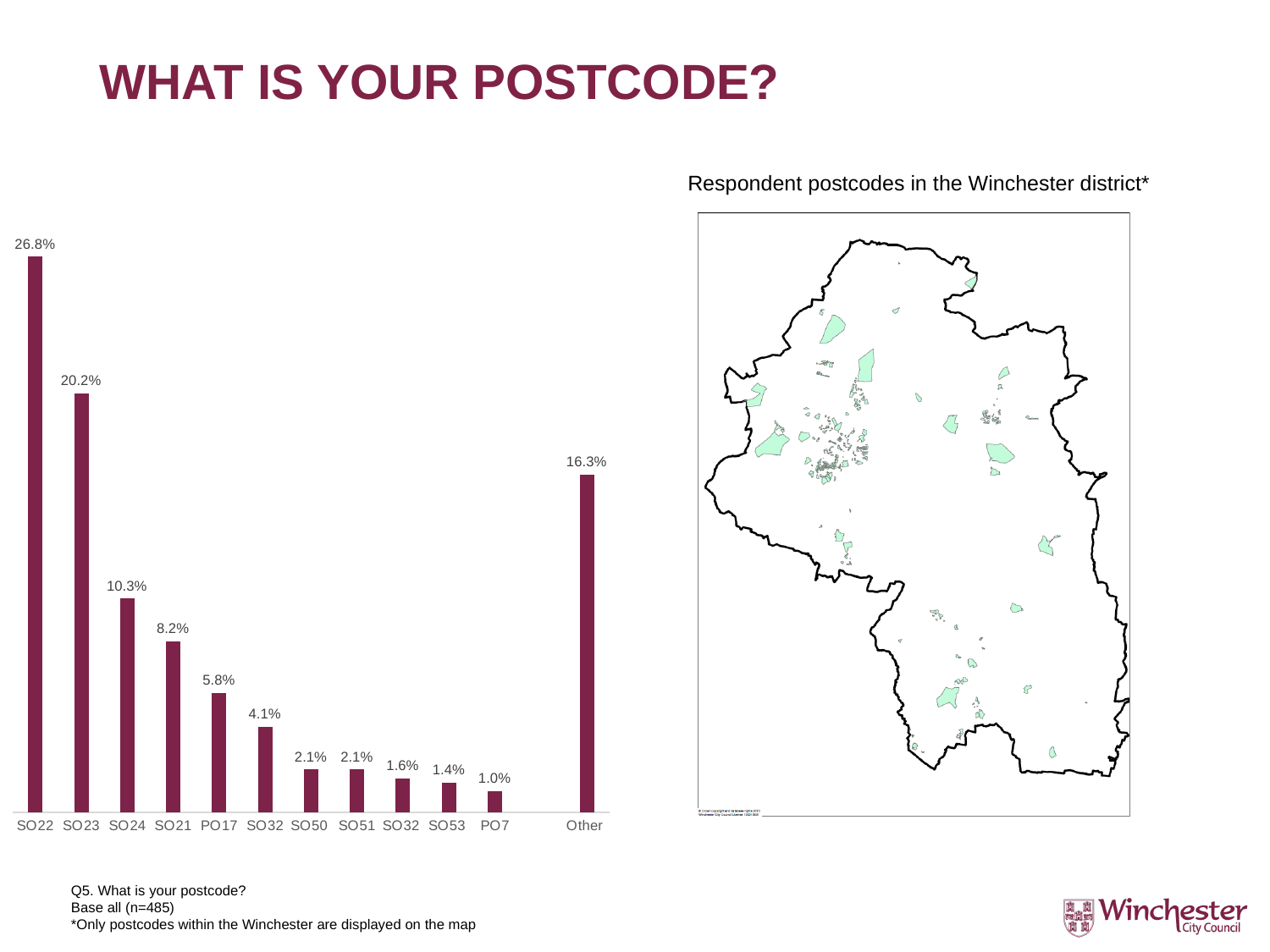
Which has a higher percentage of respondents, SO24 or Other? Other What percentage of respondents have the postcode SO22? 26.8% Which has a higher percentage of respondents, SO21 or PO17? SO21 What percentage of respondents fall into the 'Other' postcode category? 16.3% Which postcode category has the lowest percentage of respondents? PO7 What is the difference in percentage points between SO22 and SO23? 6.6% What percentage of respondents have the postcode SO23? 20.2% What percentage of respondents have the postcode PO17? 5.8% What is the base size (n) stated for the postcode question? 485 How many postcode categories are shown in the bar chart? 12 Which postcode category has the highest percentage of respondents? SO22 What type of chart is used to show the postcode distribution? Bar chart